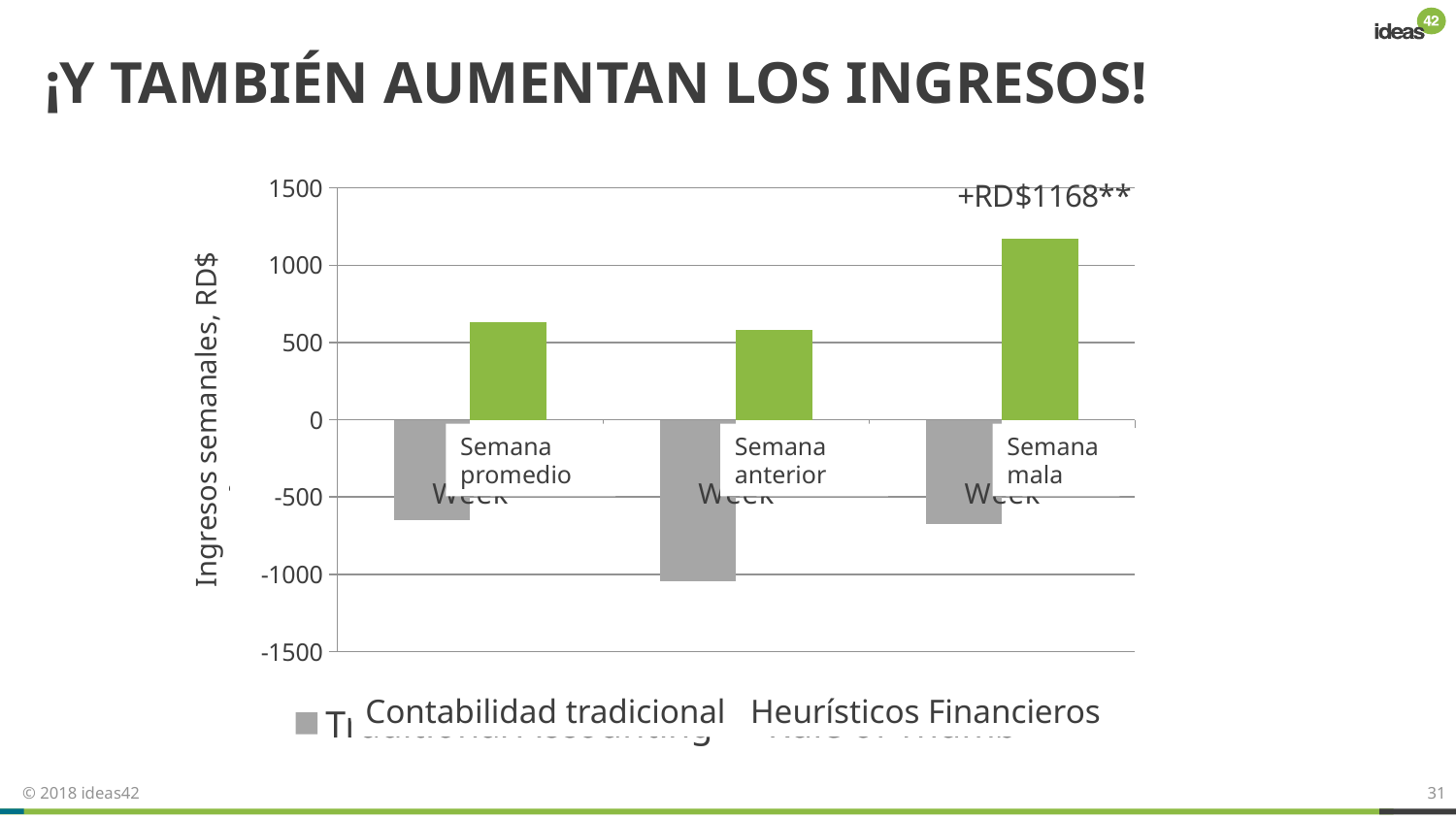
Which category has the highest value for the Heurísticos Financieros series? Semana mala Is the Contabilidad tradicional value for Semana anterior greater or less than -500? less Which category has the lowest value for the Contabilidad tradicional series? Semana anterior How many categories (weeks) are shown on the x axis of the chart? 3 Which is larger: the Heurísticos Financieros value for Semana mala or for Semana promedio? Semana mala What kind of chart is shown on the slide? bar chart Is the Heurísticos Financieros value for Semana mala greater or less than 1000? greater What annotation is printed above the Semana mala bars? +RD$1168** What is the label on the vertical axis of the chart? Ingresos semanales, RD$ How many series does the chart's legend list? 2 Is the Contabilidad tradicional value for Semana promedio greater or less than -500? less